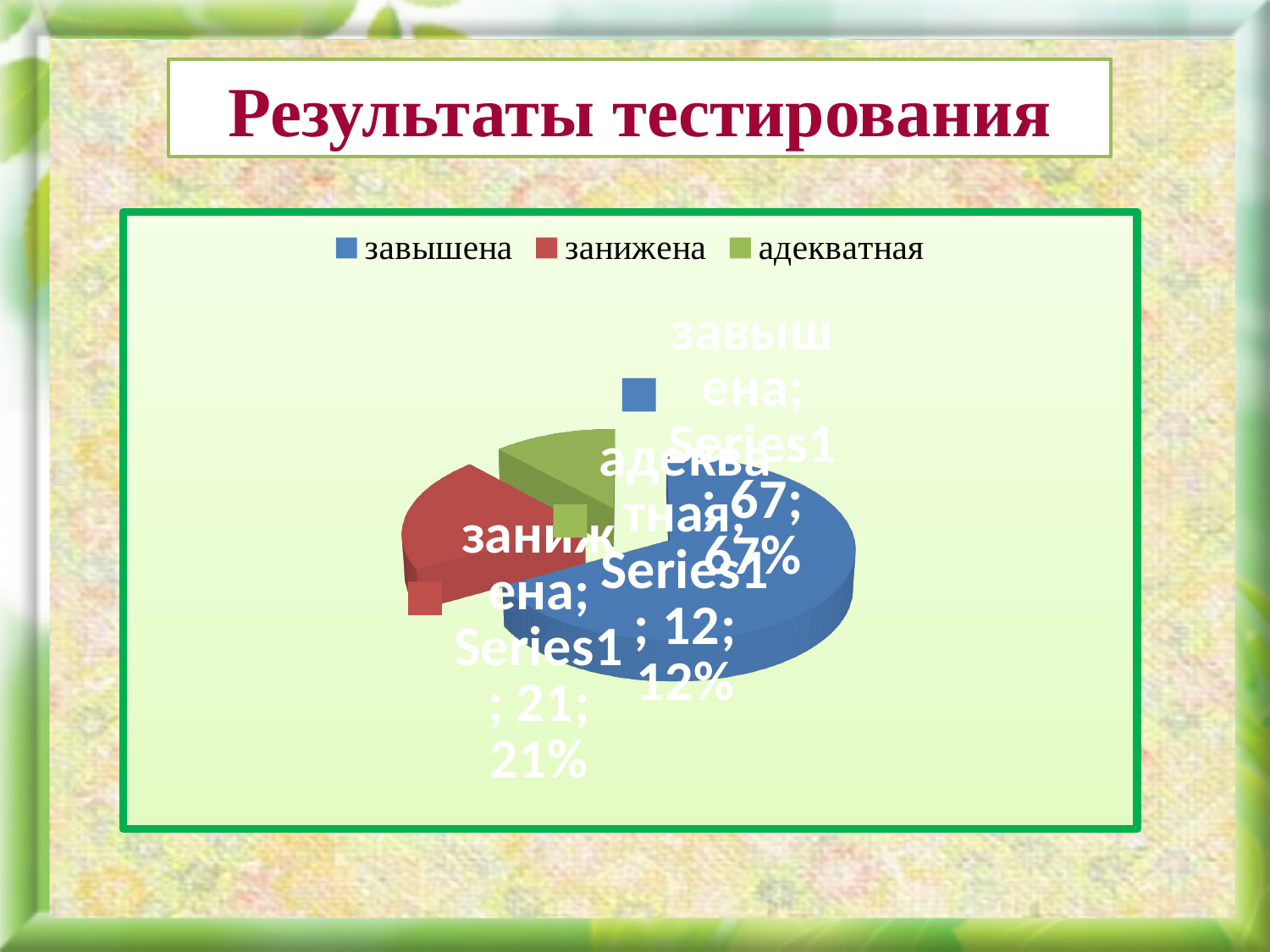
Which category has the largest slice of the pie? завышена What kind of chart is shown on the slide? pie chart What is the value shown for the category 'занижена'? 21 What is the difference between the values for 'завышена' and 'занижена'? 46 What is the value shown for the category 'завышена'? 67 Which category has the smallest slice of the pie? адекватная How many categories does the legend of the pie chart list? 3 What percentage of the pie does the slice 'занижена' represent? 21% What percentage of the pie does the slice 'завышена' represent? 67% What is the title of the slide with the chart? Результаты тестирования Which colour is used for the 'занижена' slice in the pie chart? red What percentage of the pie does the slice 'адекватная' represent? 12%